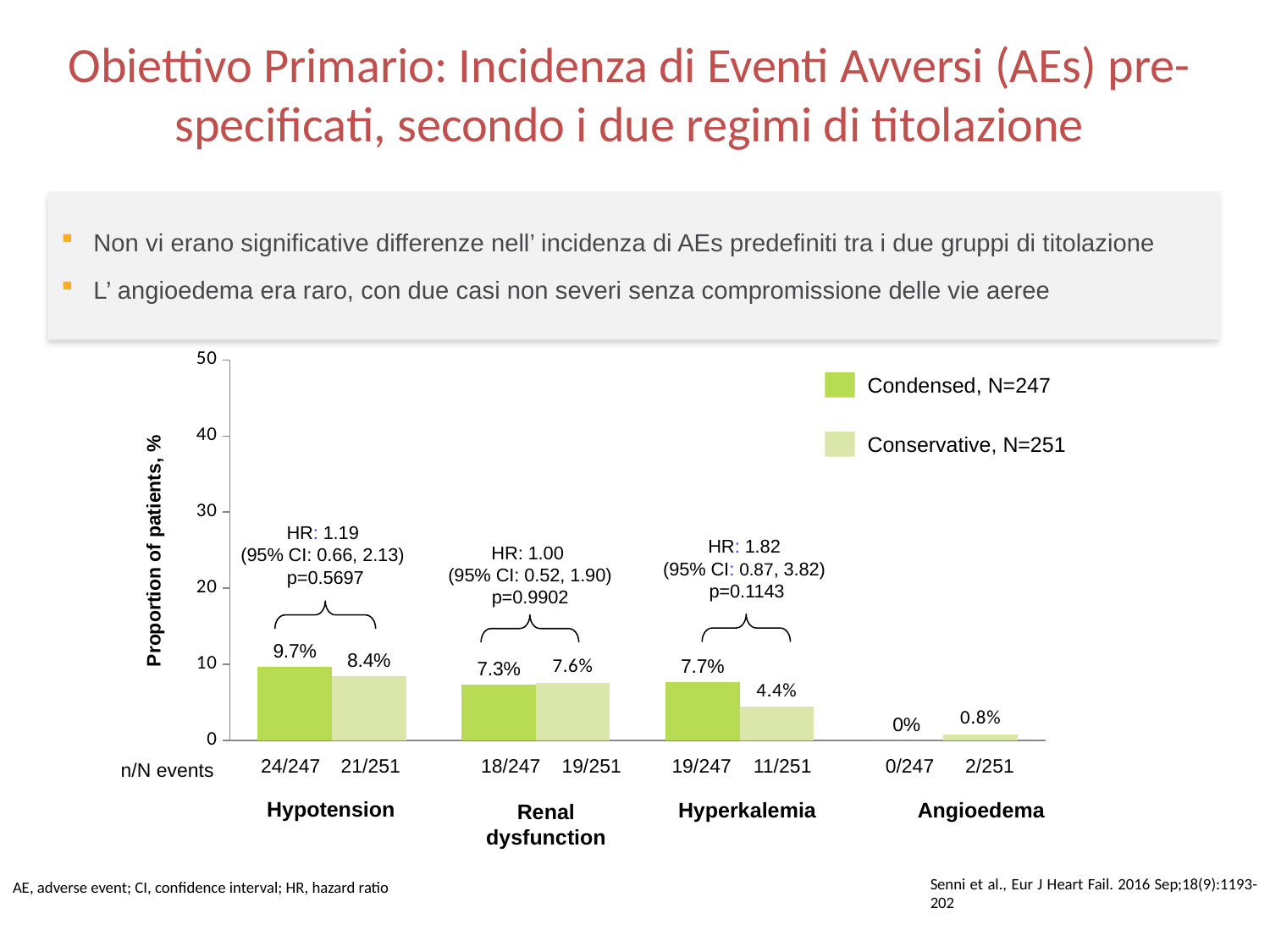
What is the difference between the Condensed and Conservative proportions for hyperkalemia? 3.3% For renal dysfunction, which group has the larger proportion of patients, Condensed or Conservative? Conservative Which adverse event category has the highest proportion in the Condensed group? Hypotension What is the hazard ratio shown for hyperkalemia? 1.82 What is the proportion of patients with angioedema in the Condensed group? 0% What kind of chart is shown on the slide? Bar chart What is the proportion of patients with hypotension in the Condensed group? 9.7% How many adverse event categories are shown on the x axis? 4 What is the proportion of patients with hyperkalemia in the Conservative group? 4.4% Which adverse event category has the lowest proportion in the Conservative group? Angioedema How many series does the legend list? 2 What is the label of the y axis? Proportion of patients, %